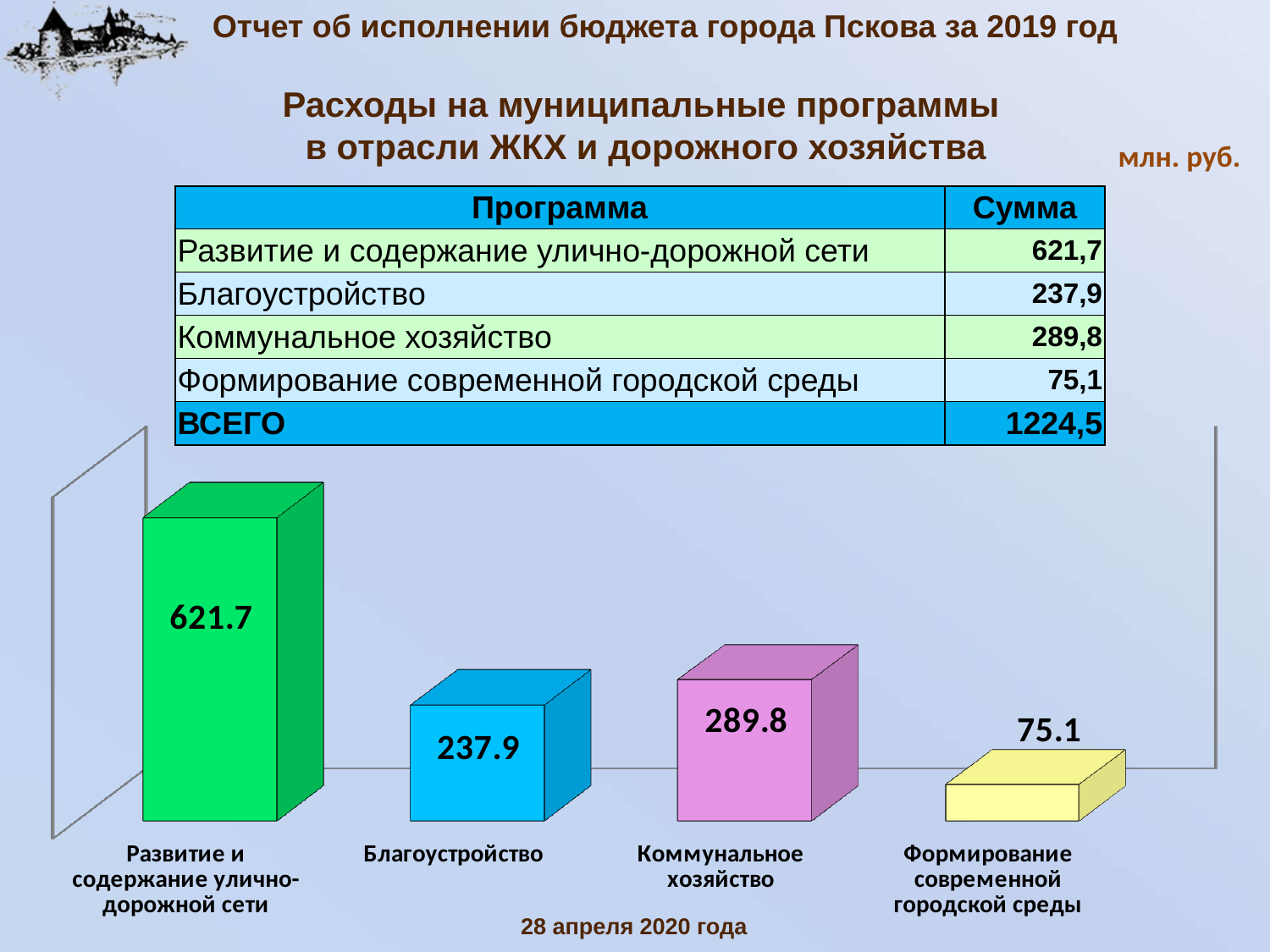
How many categories are shown in the chart? 4 Which is larger: the value for Коммунальное хозяйство or the value for Благоустройство? Коммунальное хозяйство What is the value shown for Благоустройство in the chart? 237.9 What is the difference between the values for Развитие и содержание улично-дорожной сети and Формирование современной городской среды? 546.6 What is the value shown for Коммунальное хозяйство in the chart? 289.8 What colour is the bar for Формирование современной городской среды? yellow What is the difference between the values for Коммунальное хозяйство and Благоустройство? 51.9 Which category has the highest value in the chart? Развитие и содержание улично-дорожной сети What kind of chart is shown on the slide? bar chart Which category has the lowest value in the chart? Формирование современной городской среды What is the value shown for Формирование современной городской среды in the chart? 75.1 What is the value shown for Развитие и содержание улично-дорожной сети in the chart? 621.7